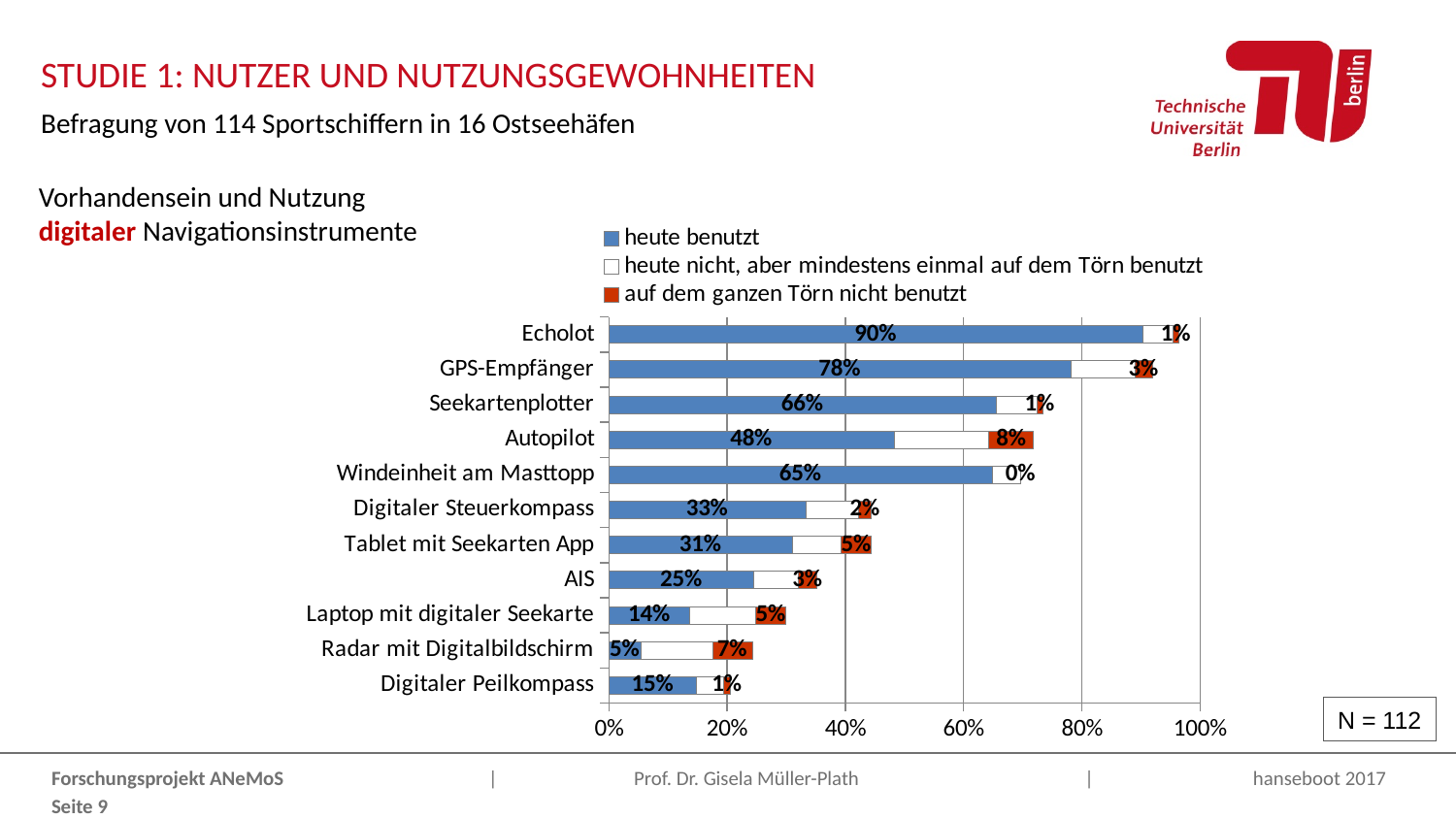
Which has a larger 'heute benutzt' value, Tablet mit Seekarten App or AIS? Tablet mit Seekarten App What is the difference between the 'heute benutzt' values for Echolot and GPS-Empfänger? 12% What is the 'auf dem ganzen Törn nicht benutzt' value for Autopilot? 8% How many navigation instruments (categories) are shown in the chart? 11 How many series does the legend list? 3 Which instrument has the highest 'heute benutzt' value? Echolot What is the 'heute benutzt' value for Autopilot? 48% What is the 'heute benutzt' value for GPS-Empfänger? 78% Which instrument has the lowest 'heute benutzt' value? Radar mit Digitalbildschirm What is the 'heute benutzt' value for Echolot? 90% What kind of chart is shown on the slide? bar chart What is the 'auf dem ganzen Törn nicht benutzt' value for Windeinheit am Masttopp? 0%